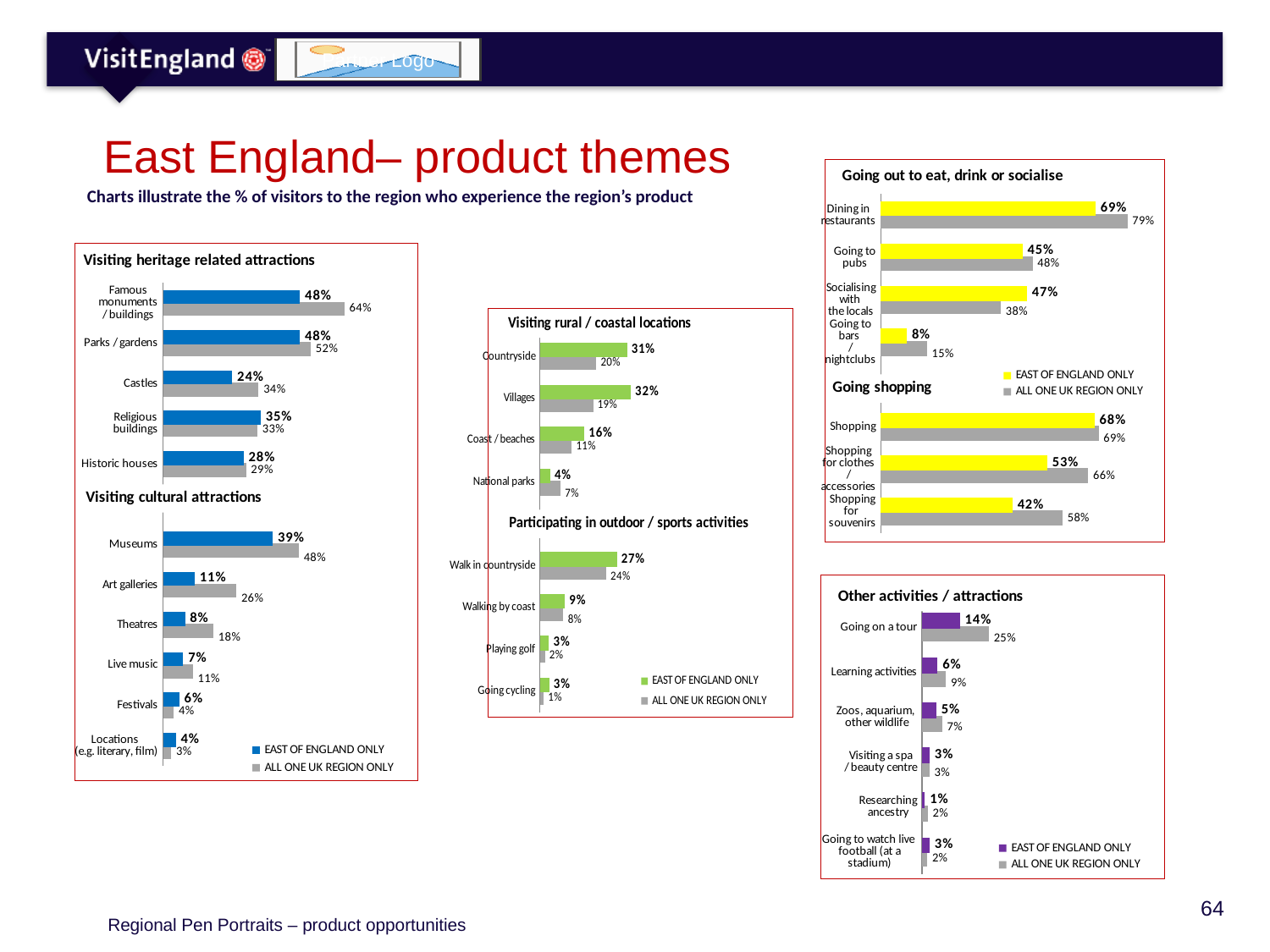
What type of chart is 'Visiting rural / coastal locations'? Bar chart In the 'Visiting heritage related attractions' chart, what is the ALL ONE UK REGION ONLY value for Castles? 34% What colour are the EAST OF ENGLAND ONLY bars in the 'Going shopping' chart? Yellow In the 'Going out to eat, drink or socialise' chart, which is larger for Socialising with the locals: EAST OF ENGLAND ONLY or ALL ONE UK REGION ONLY? EAST OF ENGLAND ONLY In the 'Other activities / attractions' chart, what is the EAST OF ENGLAND ONLY value for Going on a tour? 14% In the 'Visiting cultural attractions' chart, which category has the highest EAST OF ENGLAND ONLY value? Museums In the 'Visiting rural / coastal locations' chart, which category has the lowest EAST OF ENGLAND ONLY value? National parks In the 'Participating in outdoor / sports activities' chart, what is the ALL ONE UK REGION ONLY value for Going cycling? 1% How many series does the legend list in the 'Participating in outdoor / sports activities' chart? 2 How many categories are shown in the 'Other activities / attractions' chart? 6 In the 'Going shopping' chart, what is the difference between the ALL ONE UK REGION ONLY and EAST OF ENGLAND ONLY values for Shopping for souvenirs? 16% In the 'Going out to eat, drink or socialise' chart, what is the value for Dining in restaurants for EAST OF ENGLAND ONLY? 69%